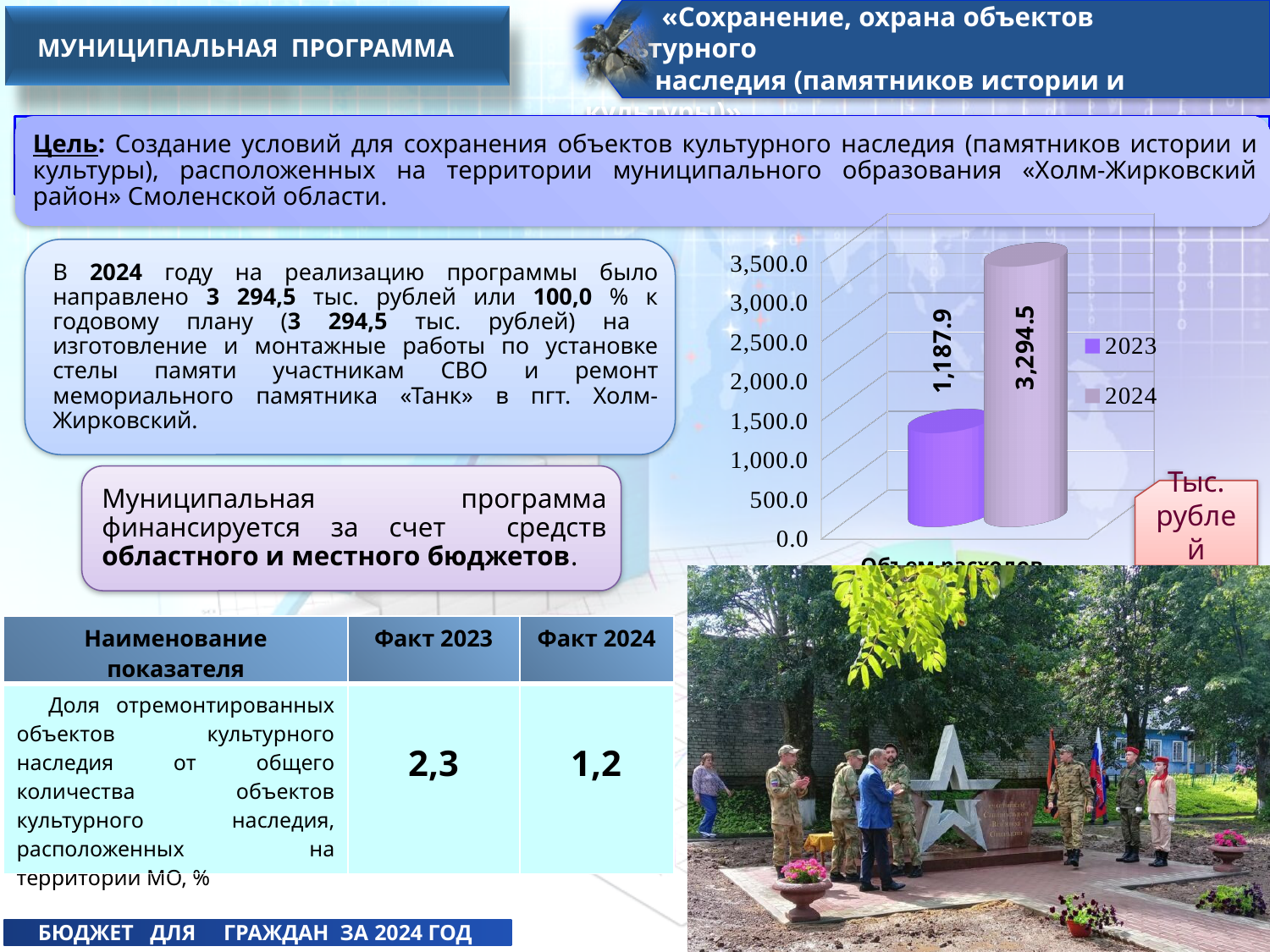
What is the highest tick value on the chart's vertical axis? 3,500.0 Do the values rise or fall from 2023 to 2024? rise Is the value for 2023 greater or less than 1,500.0? less What unit is indicated for the chart values? Тыс. рублей Is the value for 2024 greater or less than 3,000.0? greater How many series does the chart legend list? 2 Which series has the lowest value on the chart? 2023 What kind of chart is shown on the slide? bar chart Which year has the higher value on the chart, 2023 or 2024? 2024 What is the value shown for 2023 on the chart? 1,187.9 What is the value shown for 2024 on the chart? 3,294.5 What is the difference between the 2024 and 2023 values on the chart? 2,106.6